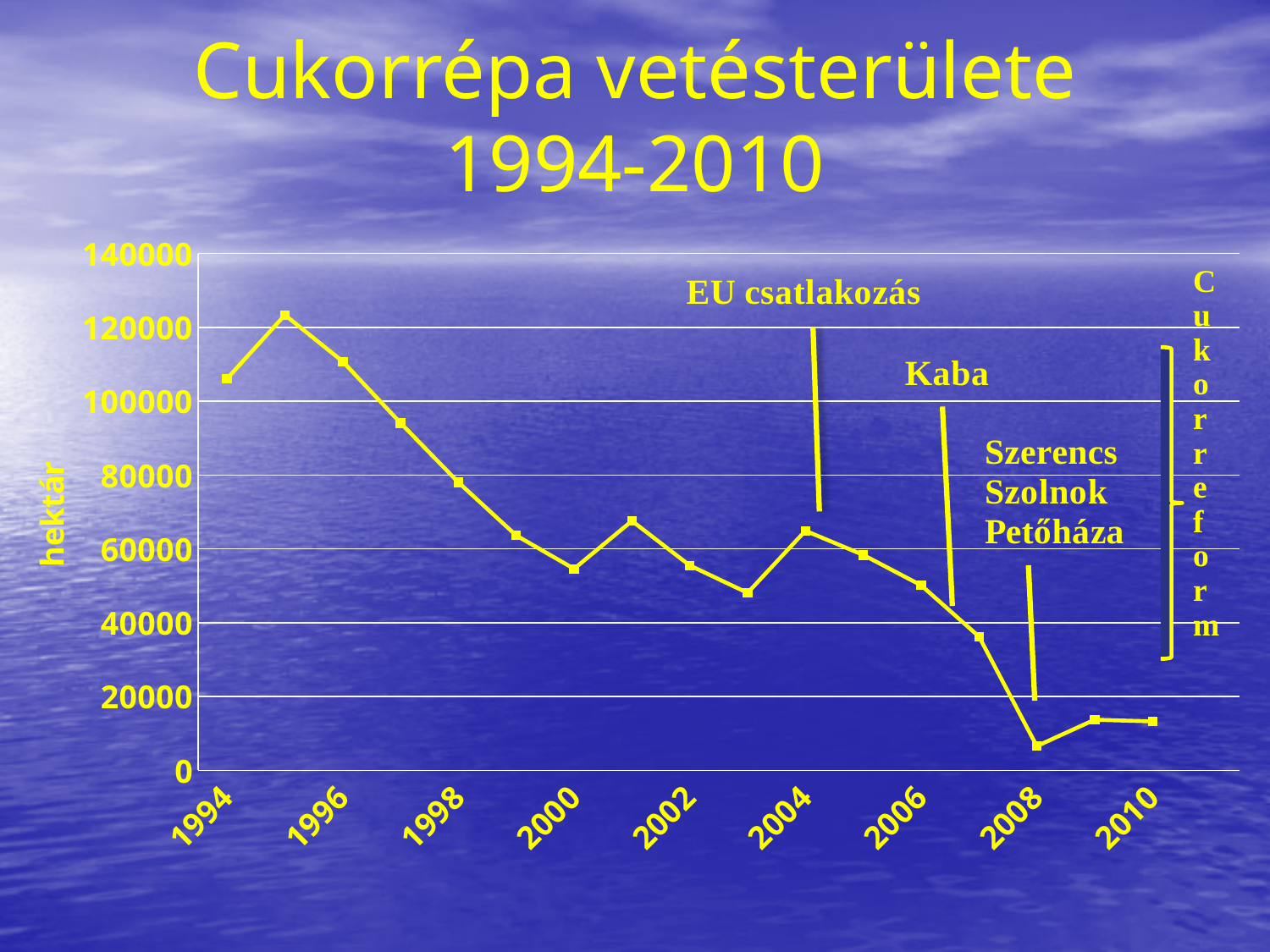
Is the value for 1996 greater or less than 100000? greater Is the value for 2006 greater or less than 40000? greater Which is larger, the value for 1994 or the value for 2010? 1994 Is the value for 2008 greater or less than 20000? less How many years are labeled on the x axis? 9 What kind of chart is shown on the slide? line chart Overall, do the values rise or fall from 1994 to 2010? fall What unit is shown on the vertical axis label? hektár What is the title of the chart on the slide? Cukorrépa vetésterülete 1994-2010 Which labeled year on the x axis has the lowest value? 2008